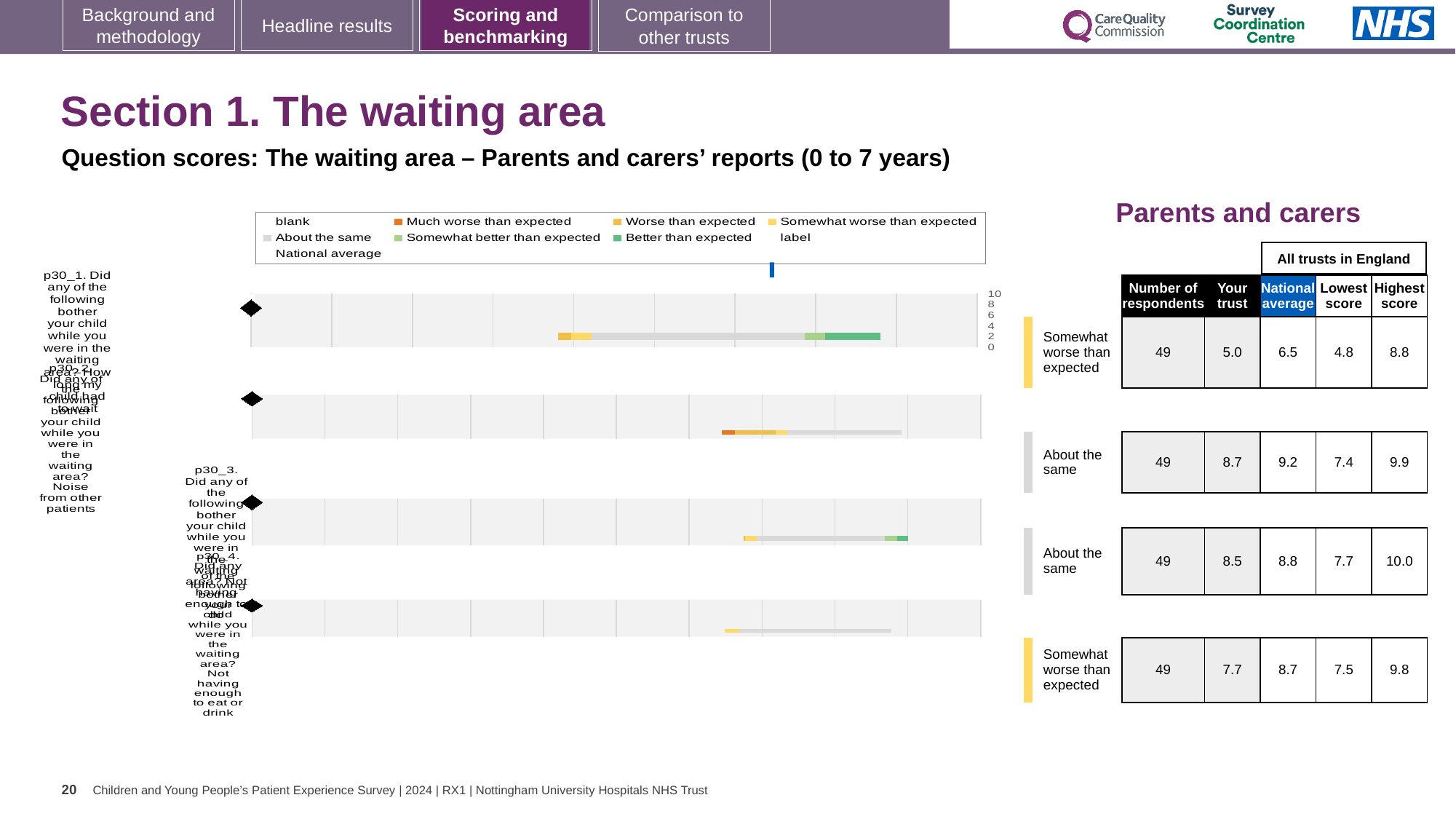
In the table, what is the difference between the national average and 'Your trust' score in the first row? 1.5 What kind of chart is shown on the slide? bar chart In the table, what is the 'Your trust' score for the first row (Somewhat worse than expected, p30_1)? 5.0 Which legend entry is shown in orange? Much worse than expected In the table, is the 'Your trust' score in the fourth row larger or smaller than the national average in that row? smaller How many entries does the chart legend list? 9 In the table, how many respondents are listed for the fourth row (Somewhat worse than expected, p30_4)? 49 How many survey questions (bars) are plotted in the chart? 4 In the table, what is the highest score for the third row (About the same, p30_3)? 10.0 What is the highest value shown on the chart's axis? 10 In the table, which row has the highest 'Your trust' score? About the same (p30_2), 8.7 In the table, what is the national average for the second row (About the same, p30_2)? 9.2